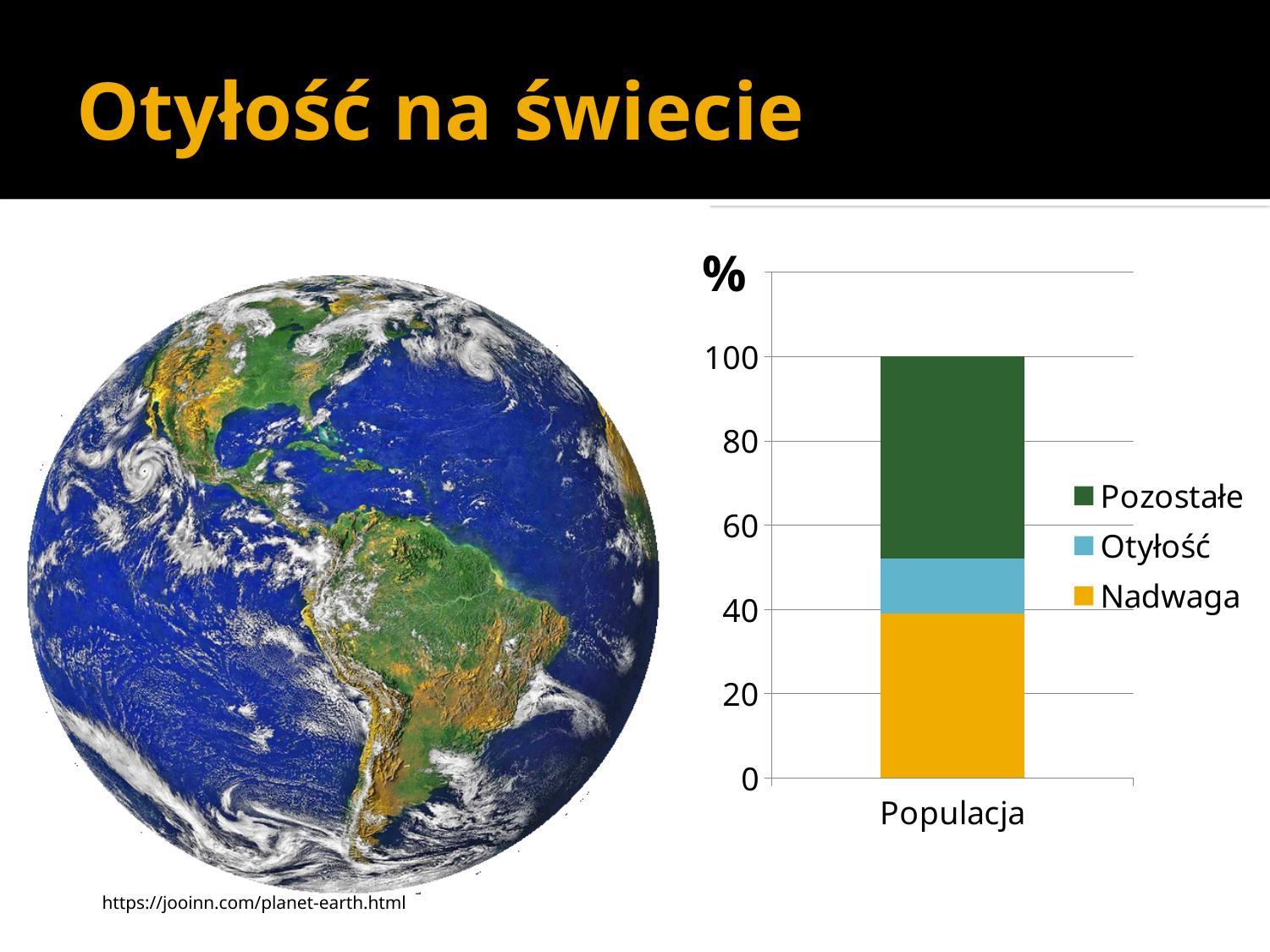
Is the value of the Nadwaga segment greater or less than 20? greater What kind of chart is shown on the slide? stacked bar chart How many series does the chart legend list? 3 How many categories are shown on the x axis of the chart? 1 What is the total height of the stacked bar for Populacja? 100 What colour is the Nadwaga series in the chart? yellow Which series forms the smallest segment of the Populacja bar? Otyłość Is the value of the Pozostałe segment greater or less than 40? greater Is the value of the Otyłość segment greater or less than 20? less What label is shown at the top of the vertical axis of the chart? % Which is larger in the Populacja bar, the Nadwaga segment or the Otyłość segment? Nadwaga Which series forms the largest segment of the Populacja bar? Pozostałe